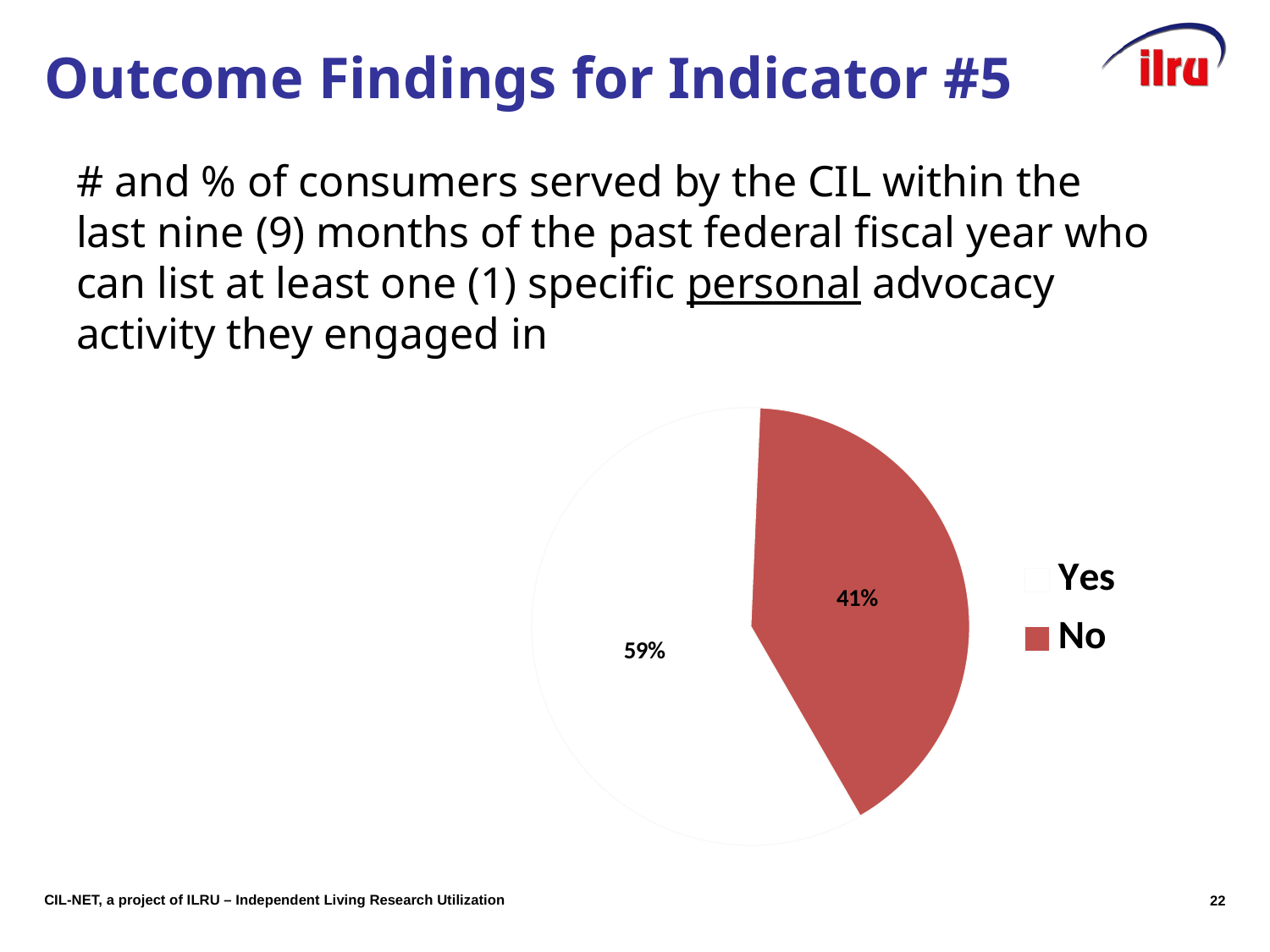
How many entries does the legend list? 2 What is the difference in percentage points between the "Yes" and "No" slices? 18 Which slice of the pie is the smallest? No What percentage of the pie is labelled "No"? 41% What colour is the "No" slice in the pie chart? red What share of the pie does the "No" slice represent? 41% How many slices does the pie chart have? 2 What type of chart is shown on the slide? pie chart Is the "Yes" slice greater or less than 50% of the pie? greater Which is larger, the "Yes" slice or the "No" slice? Yes What percentage of the pie is labelled "Yes"? 59% Which slice of the pie is the largest? Yes